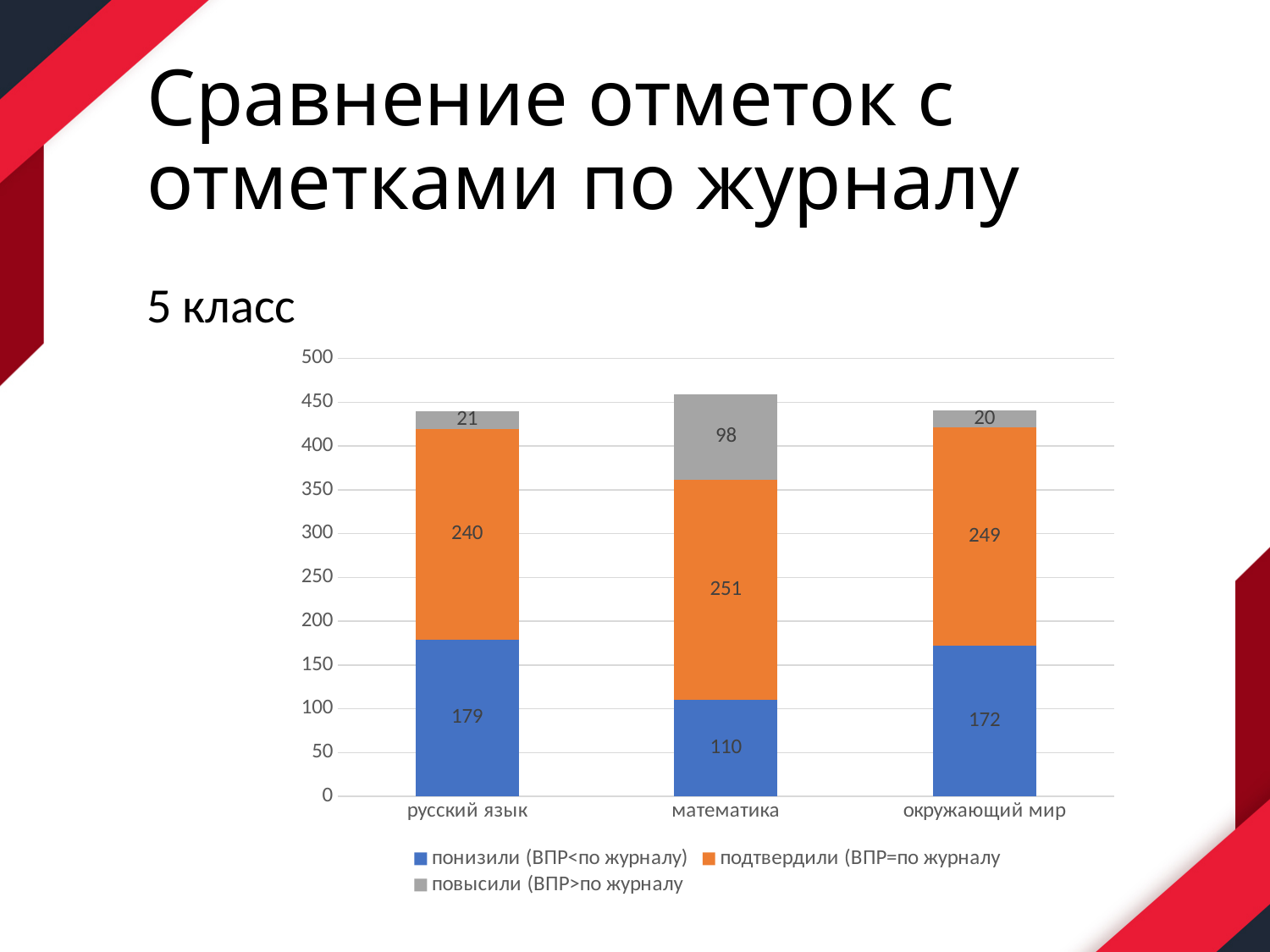
What is the total of the stacked bar for русский язык? 440 How many categories are shown on the x axis of the chart? 3 Which is larger: the 'понизили (ВПР<по журналу)' value for русский язык or for окружающий мир? русский язык What is the value of the 'понизили (ВПР<по журналу)' series for математика? 110 What is the total of the stacked bar for математика? 459 What is the value of the 'повысили (ВПР>по журналу' series for русский язык? 21 Which category has the highest value for the 'повысили (ВПР>по журналу' series? математика What is the value of the 'подтвердили (ВПР=по журналу' series for окружающий мир? 249 How many series does the chart legend list? 3 Which category has the lowest value for the 'понизили (ВПР<по журналу)' series? математика What type of chart is shown on the slide? stacked bar chart What is the difference between the 'подтвердили (ВПР=по журналу' values for математика and русский язык? 11